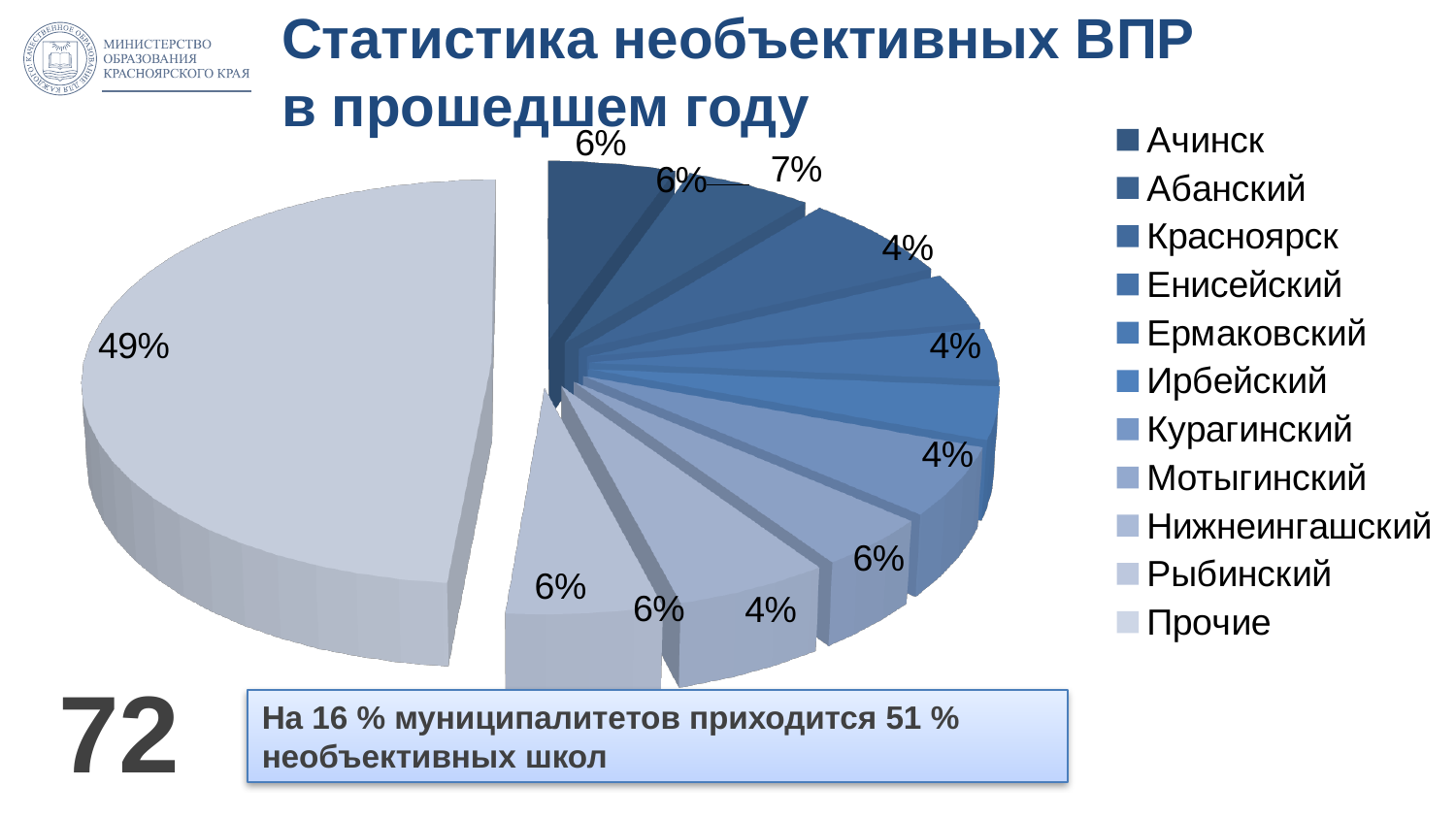
Which legend entry is listed last in the pie chart's legend? Прочие What share of the pie does the 'Прочие' slice take? 49% How many categories does the legend of the pie chart list? 11 What is the largest percentage label shown on the pie chart? 49% What kind of chart is shown on the slide? pie chart What is the smallest percentage label shown on the pie chart? 4% Is the share of 'Прочие' greater or less than 40%? greater Which is larger: the slice for 'Прочие' or the slice for 'Красноярск'? Прочие Which category has the largest slice in the pie chart? Прочие What share of the pie does the 'Красноярск' slice take? 7% What is the title of the chart on the slide? Статистика необъективных ВПР в прошедшем году What is the difference between the 'Прочие' slice (49%) and the 'Красноярск' slice (7%)? 42%